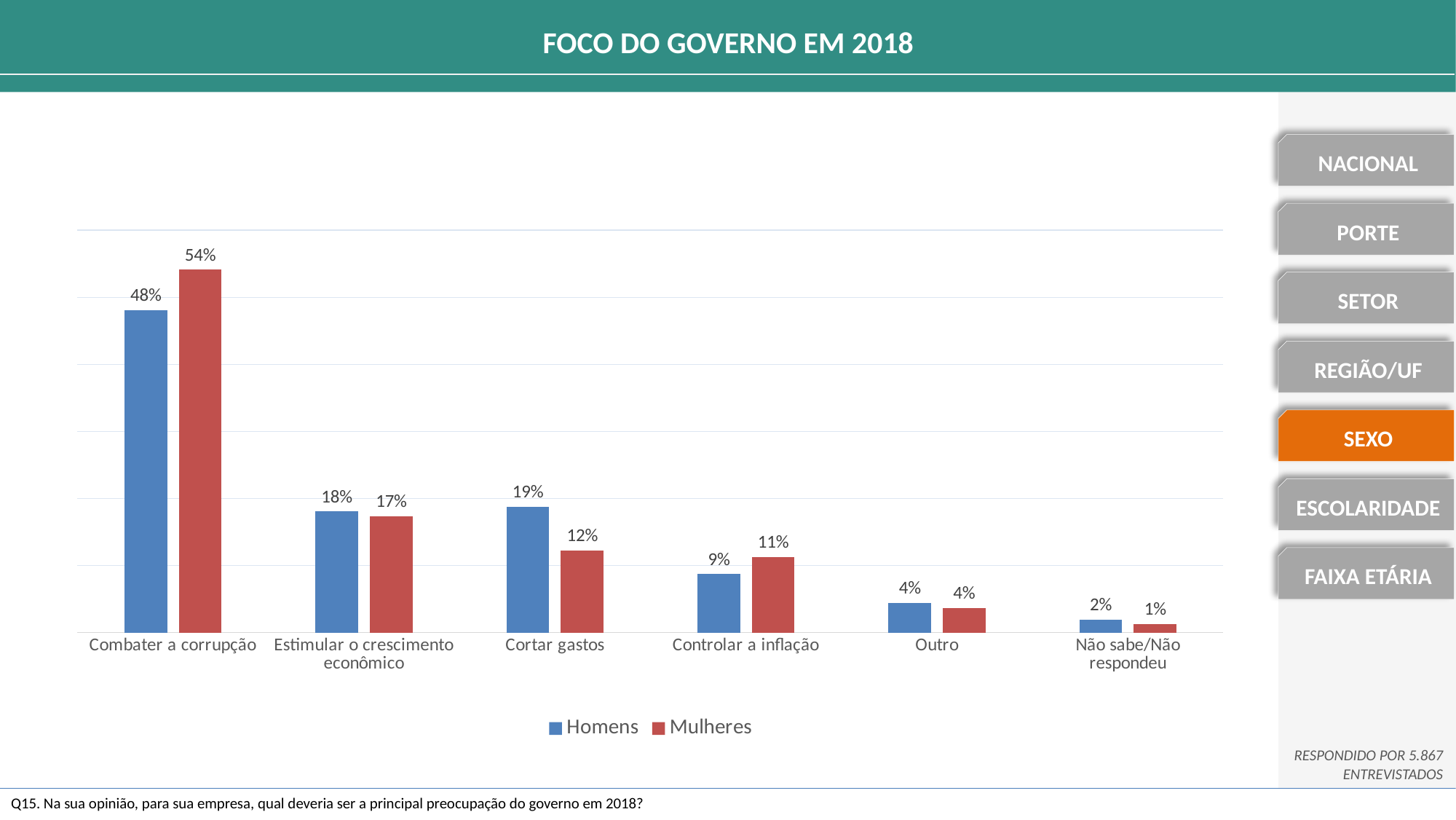
What is the value for Homens in the Controlar a inflação category? 9% What is the difference between the Mulheres and Homens values for Combater a corrupção? 6% What is the value for Mulheres in the Combater a corrupção category? 54% How many series does the legend list? 2 What is the value for Mulheres in the Cortar gastos category? 12% How many categories are shown on the x axis? 6 What is the value for Homens in the Combater a corrupção category? 48% Which category has the lowest value for Homens? Não sabe/Não respondeu What is the difference between the Homens and Mulheres values for Cortar gastos? 7% Which is larger for Estimular o crescimento econômico: Homens or Mulheres? Homens What kind of chart is shown on the slide? Bar chart Which category has the highest value for Mulheres? Combater a corrupção